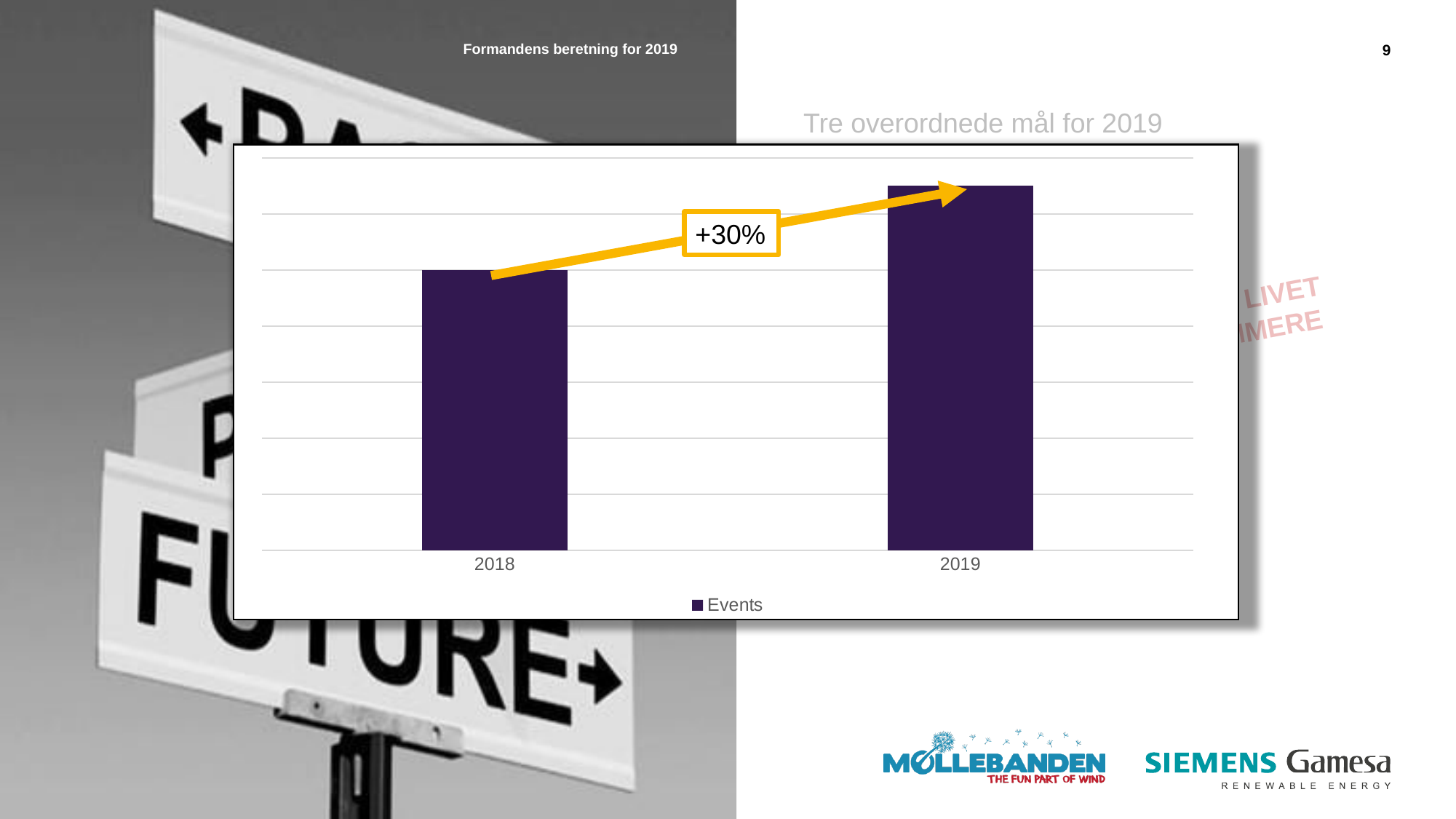
What percentage change is annotated on the arrow between the 2018 and 2019 bars? +30% Is the bar for 2019 larger or smaller than the bar for 2018? larger Which year has the higher bar in the chart? 2019 Which year has the lower bar in the chart? 2018 How many series does the chart's legend list? 1 How many categories are plotted on the x axis of the chart? 2 Do the values rise or fall from 2018 to 2019? rise What series name is shown in the chart's legend? Events What kind of chart is shown on the slide? bar chart